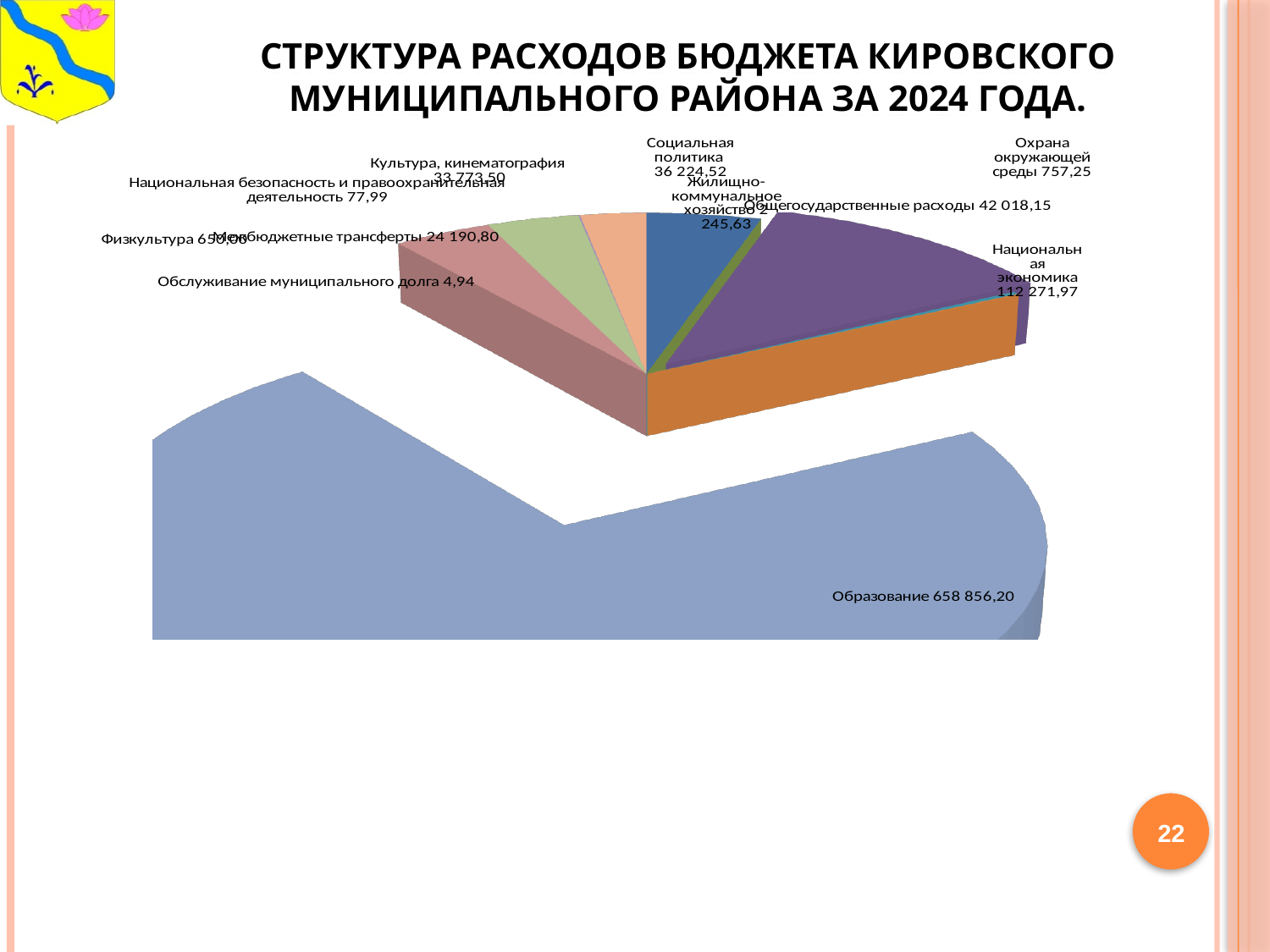
What kind of chart is shown on the slide? Pie chart What is the value shown for Образование? 658 856,20 Which category has the smallest value on the chart? Обслуживание муниципального долга What is the value shown for Национальная экономика? 112 271,97 What is the value shown for Охрана окружающей среды? 757,25 What is the value shown for Культура, кинематография? 33 773,50 What is the difference between the values for Национальная экономика and Общегосударственные расходы? 70 253,82 What is the value shown for Социальная политика? 36 224,52 What is the value shown for Межбюджетные трансферты? 24 190,80 What is the value shown for Общегосударственные расходы? 42 018,15 Which category has the largest share of the pie? Образование Which is larger: Общегосударственные расходы or Социальная политика? Общегосударственные расходы